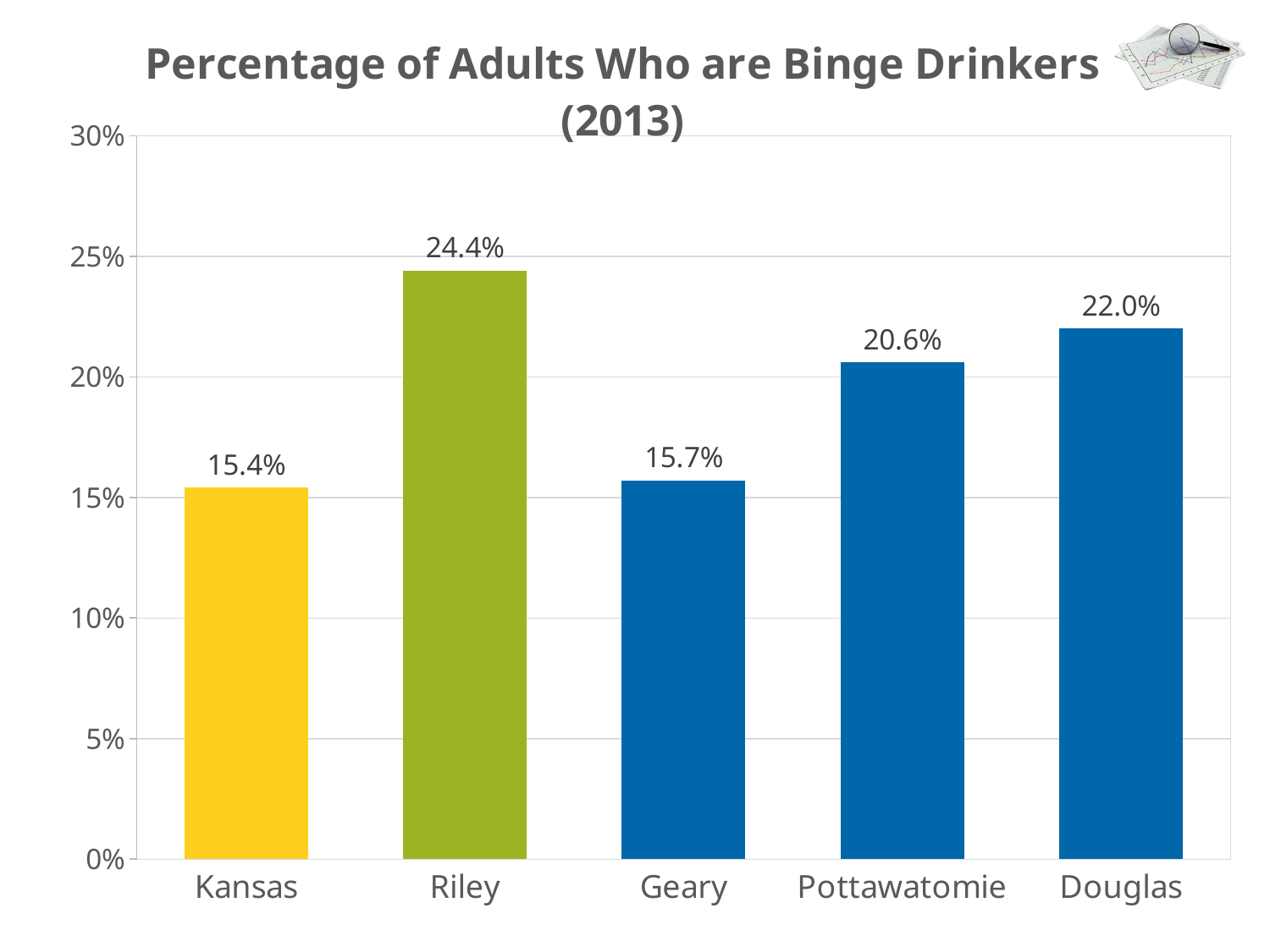
What is the percentage of adults who are binge drinkers in Kansas? 15.4% What is the value shown for Pottawatomie? 20.6% What is the difference between the values for Douglas and Pottawatomie? 1.4% Is the value for Geary greater or less than 20%? less What is the percentage of adults who are binge drinkers in Riley? 24.4% Which category has the lowest percentage of binge drinkers? Kansas Which category has the highest percentage of binge drinkers? Riley Which has a higher percentage of binge drinkers, Douglas or Geary? Douglas What kind of chart is shown on the slide? Bar chart How many categories are shown on the chart? 5 What is the difference between the values for Riley and Kansas? 9.0% What is the value shown for Douglas? 22.0%